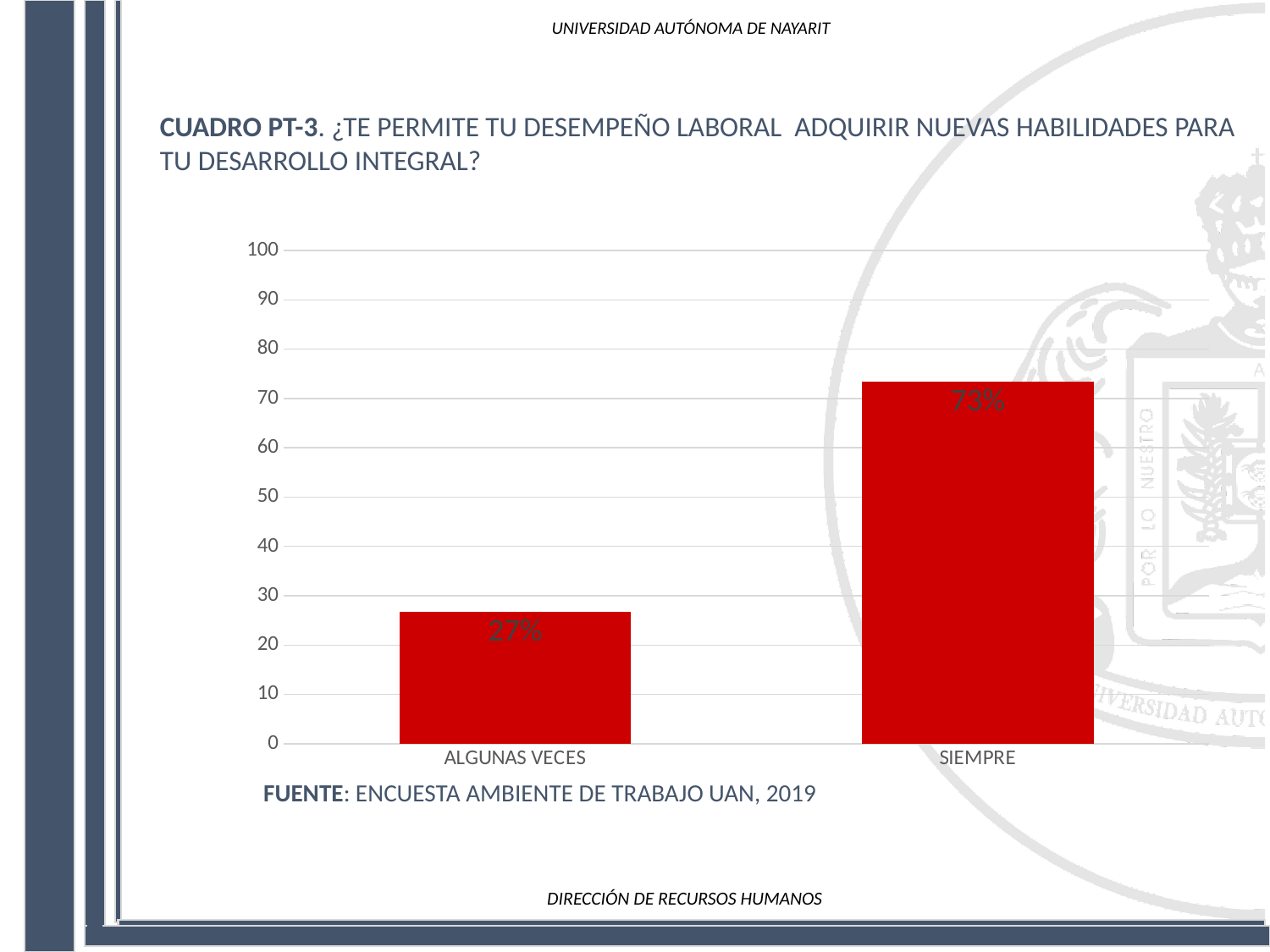
How many categories are shown on the x axis? 2 What source is cited below the chart? ENCUESTA AMBIENTE DE TRABAJO UAN, 2019 What kind of chart is shown on the slide? Bar chart Which category has the highest value? SIEMPRE Which is larger, the value for ALGUNAS VECES or the value for SIEMPRE? SIEMPRE What is the maximum value shown on the y axis? 100 What is the value for SIEMPRE? 73% Which category has the lowest value? ALGUNAS VECES What is the difference between the values for SIEMPRE and ALGUNAS VECES? 46% Is the value for SIEMPRE greater or less than 50? greater Is the value for ALGUNAS VECES greater or less than 30? less What is the value for ALGUNAS VECES? 27%